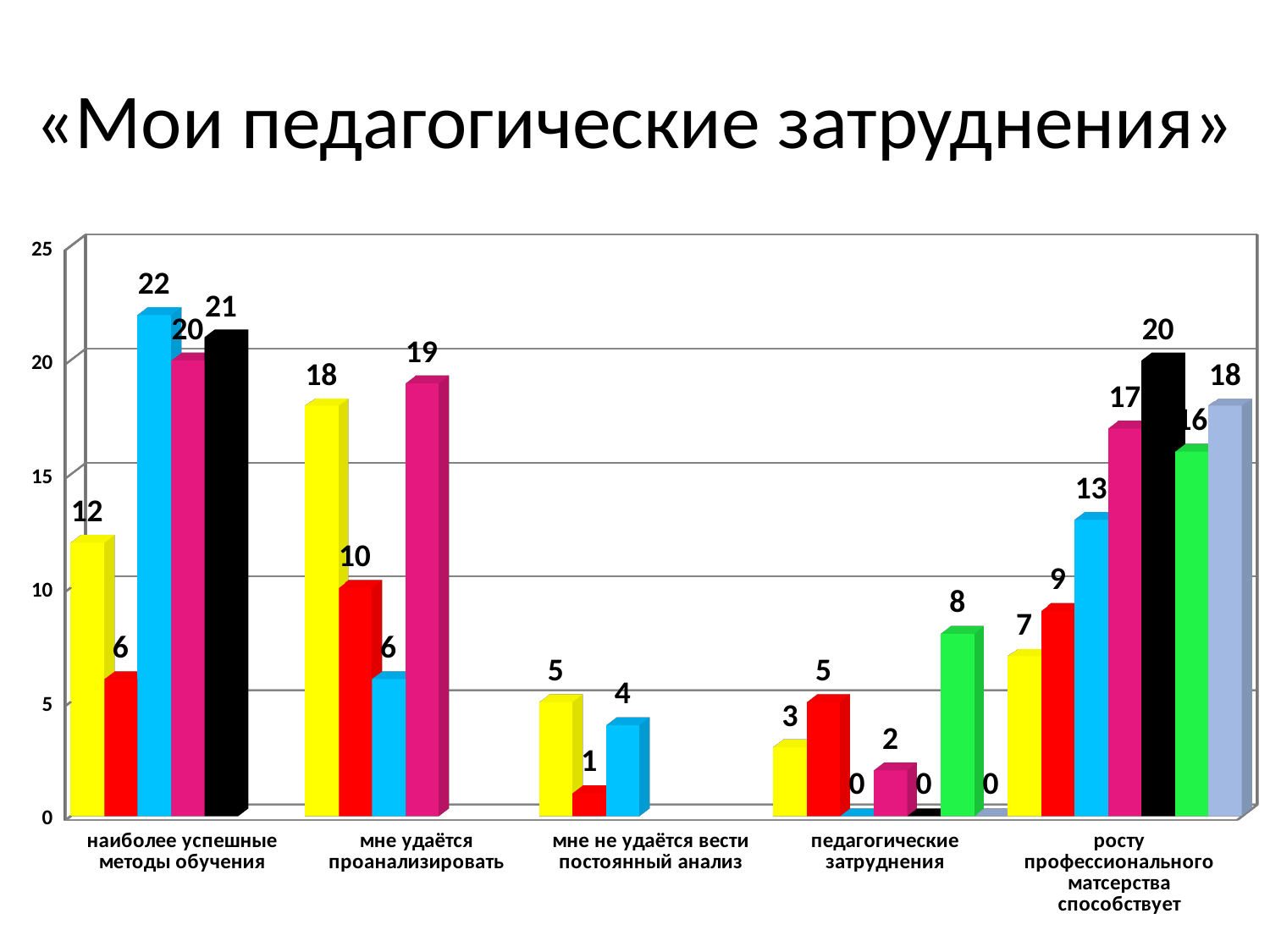
What is the title of the slide? «Мои педагогические затруднения» What is the difference between the black bar and the yellow bar for "росту профессионального матсерства способствует"? 13 Which bar is the highest in the "наиболее успешные методы обучения" category? the cyan bar (22) What is the value of the cyan bar for "наиболее успешные методы обучения"? 22 How many categories are shown along the x axis of the chart? 5 What kind of chart is shown on the slide? bar chart What is the difference between the yellow bar and the red bar for "мне удаётся проанализировать"? 8 Which bar is the lowest in the "мне не удаётся вести постоянный анализ" category? the red bar (1) What is the value of the magenta bar for "мне удаётся проанализировать"? 19 Which is larger for "росту профессионального матсерства способствует": the magenta bar or the green bar? the magenta bar What is the value of the green bar for "педагогические затруднения"? 8 What is the value of the black bar for "росту профессионального матсерства способствует"? 20